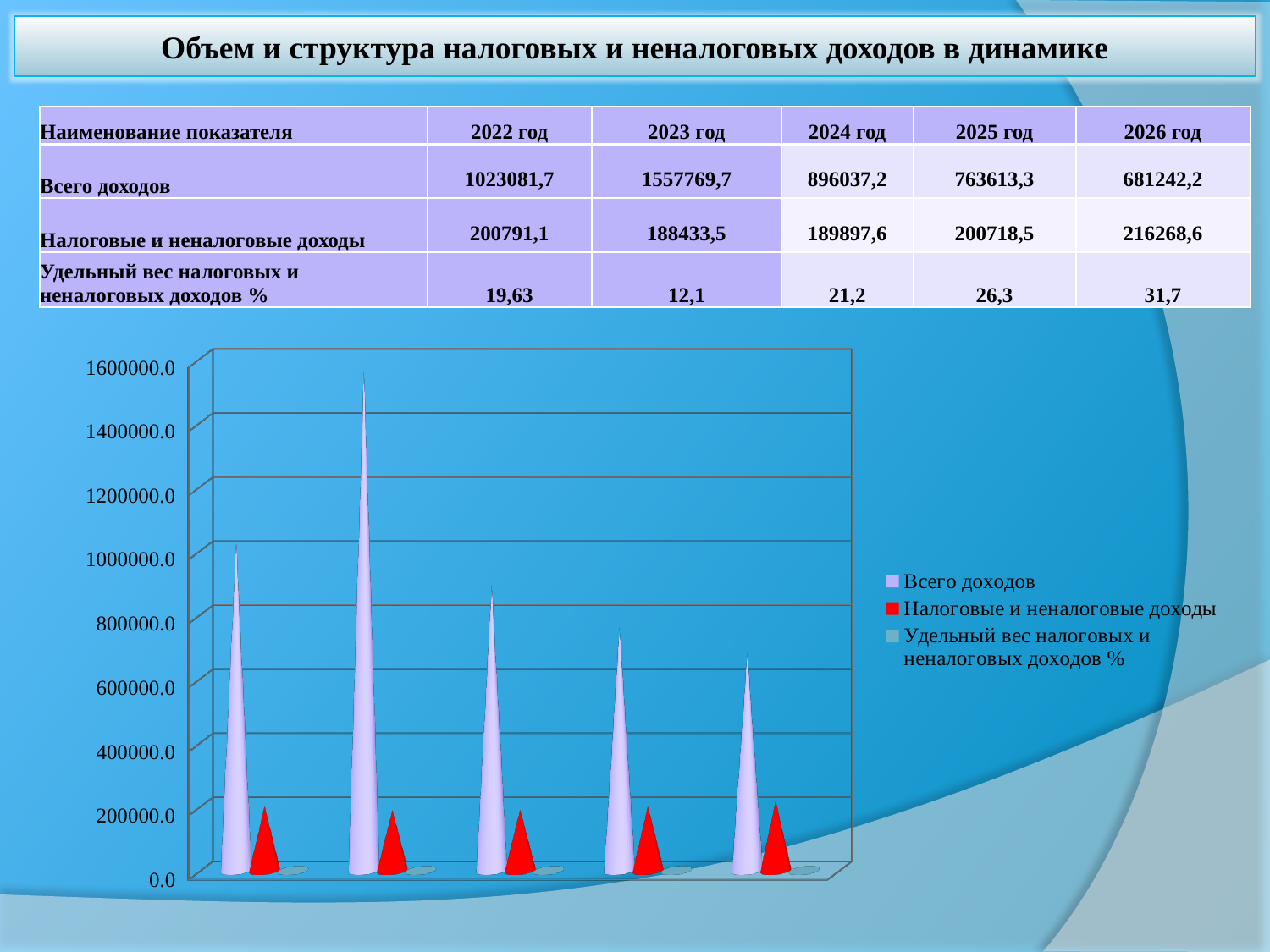
According to the table, what is the value of 'Всего доходов' for 2023 год? 1557769,7 Which colour represents the series 'Налоговые и неналоговые доходы' in the chart? red Is the 'Всего доходов' cone in the fifth group greater or less than 800000.0? less Which is larger: the 'Всего доходов' cone in the first group or in the third group? the first group Which group of cones has the tallest 'Всего доходов' cone? the second group (2023 год) What kind of chart is shown on the slide? bar chart Is the 'Всего доходов' cone in the third group greater or less than 1000000.0? less Do the 'Всего доходов' cones rise or fall from the second group to the fifth group? fall How many series does the chart legend list? 3 What is the highest value shown on the chart's vertical axis? 1600000.0 How many groups of cones are plotted along the x axis of the chart? 5 Is the tallest 'Всего доходов' cone greater or less than 1400000.0? greater